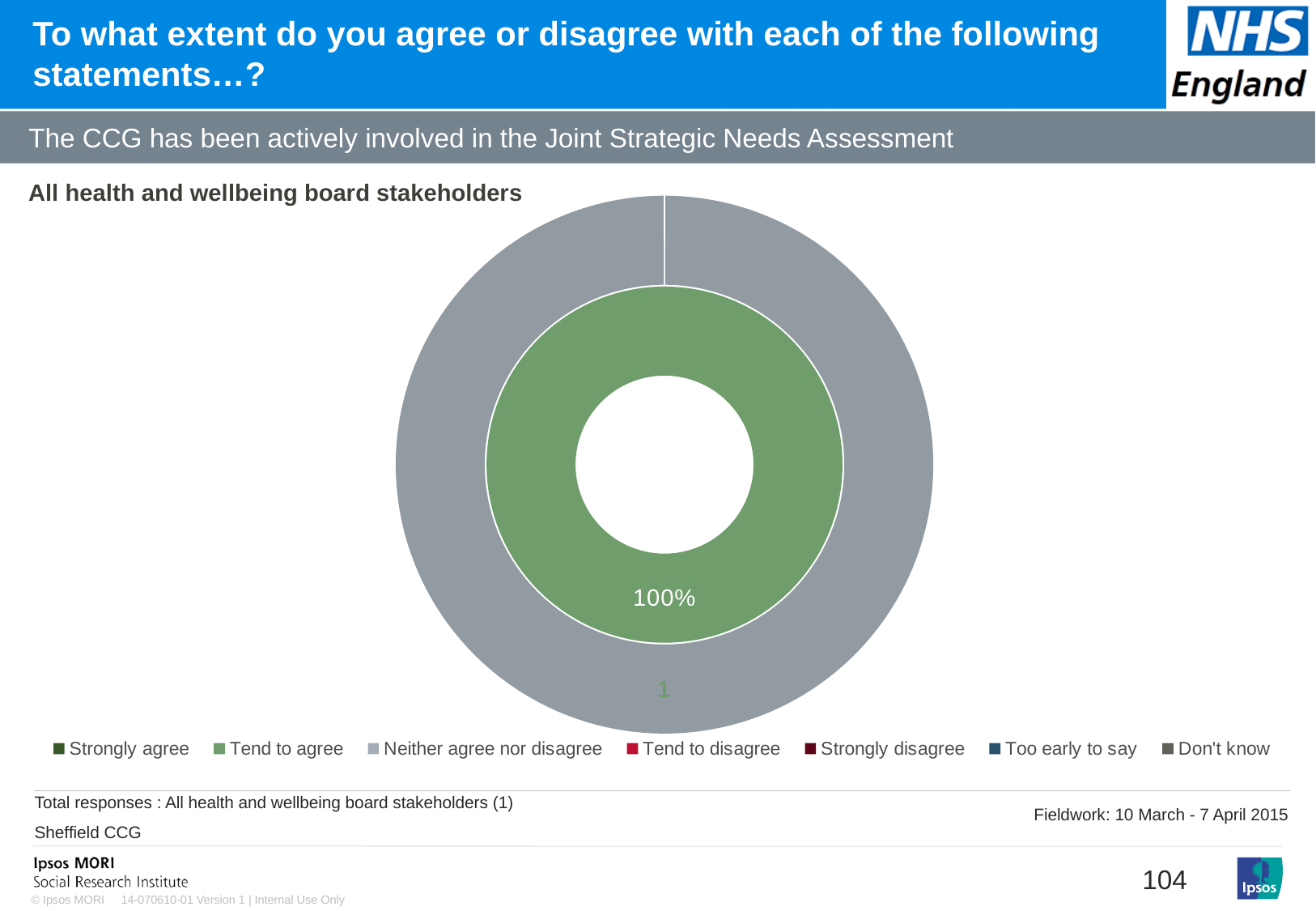
Which legend entry appears first, on the far left? Strongly agree Which group of respondents does the chart cover, according to the label above it? All health and wellbeing board stakeholders Which response category accounts for the whole of the inner doughnut? Tend to agree How many segments with a data label are shown in the inner doughnut? 1 What kind of chart is shown on the slide? Doughnut chart What percentage is shown for the green 'Tend to agree' segment? 100% Is the value for 'Tend to agree' greater or less than 50%? greater What colour is the segment labelled 100%? Green How many entries does the legend list? 7 What share of the doughnut does 'Tend to agree' take up? 100% What is the total number of responses stated for all health and wellbeing board stakeholders? 1